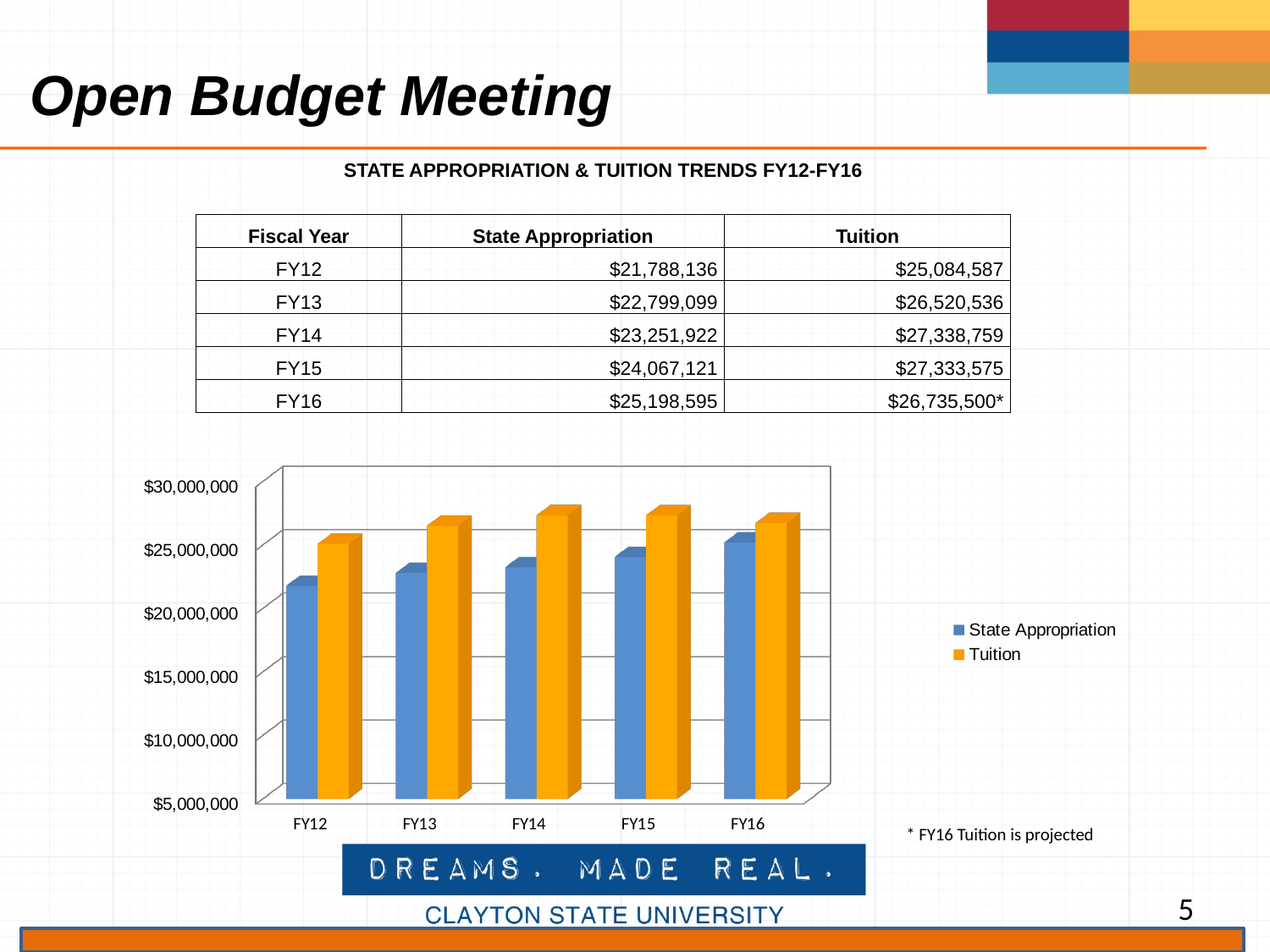
How much higher is the State Appropriation in FY16 than in FY12? $3,410,459 What is the State Appropriation for FY14? $23,251,922 How many fiscal years are shown on the x axis of the chart? 5 Is the State Appropriation for FY13 greater or less than $25,000,000? less What kind of chart is shown on the slide? bar chart In FY15, which is larger: State Appropriation or Tuition? Tuition What is the title of the table and chart on the slide? STATE APPROPRIATION & TUITION TRENDS FY12-FY16 How many series does the chart legend list? 2 Which fiscal year has the lowest Tuition? FY12 What is the Tuition value for FY13? $26,520,536 Does the State Appropriation rise or fall from FY12 to FY16? rise Which fiscal year has the highest State Appropriation? FY16